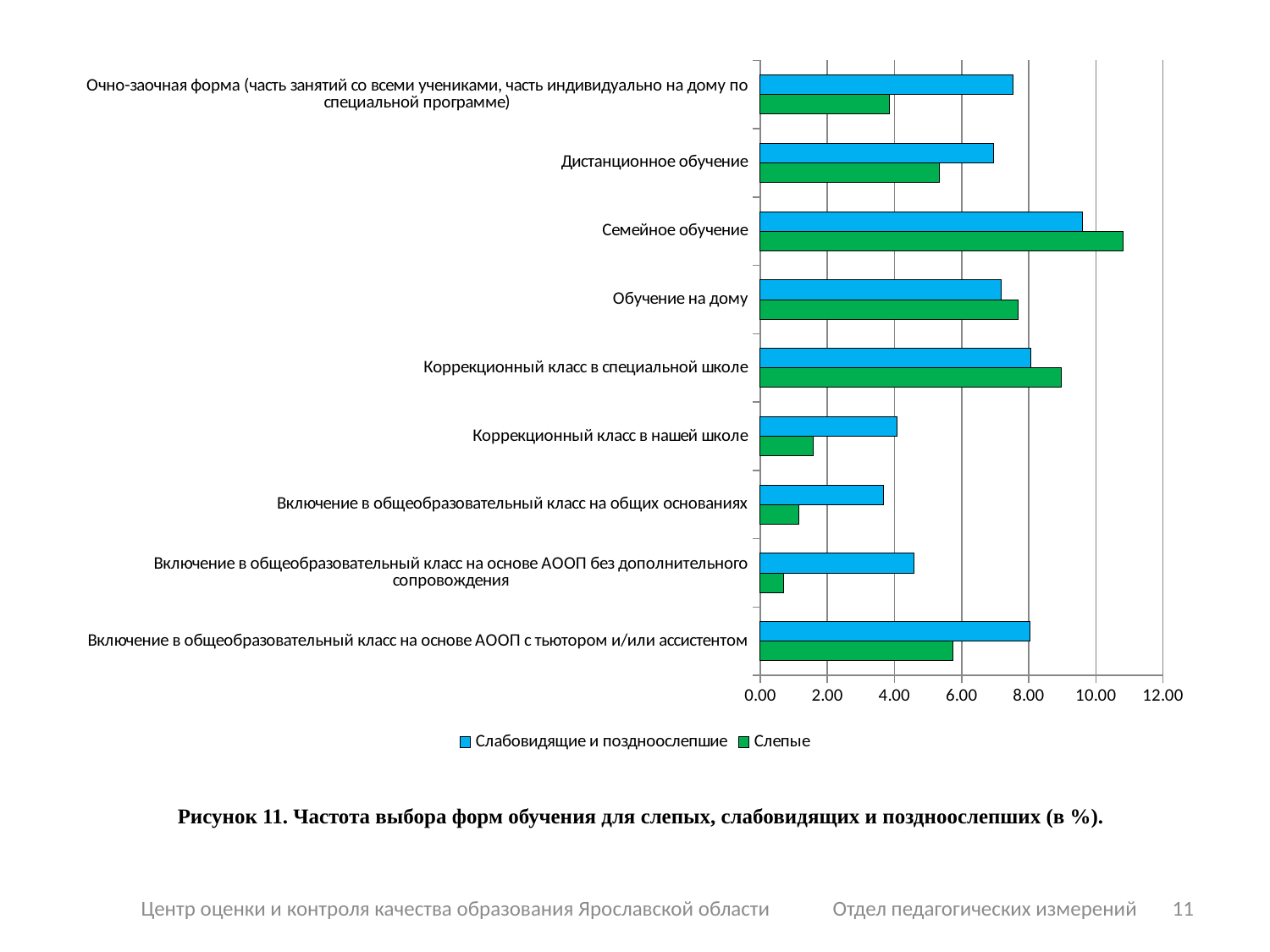
What kind of chart is shown on the slide? bar chart Is the value for "Семейное обучение" in the series "Слепые" greater or less than 10.00? greater How many categories (forms of education) are shown on the chart? 9 How many series does the legend list? 2 Which category has the lowest value for the series "Слепые"? Включение в общеобразовательный класс на основе АООП без дополнительного сопровождения For "Коррекционный класс в нашей школе", which series has the larger value: "Слепые" or "Слабовидящие и позднослепшие"? Слабовидящие и позднослепшие For "Семейное обучение", which series has the larger value: "Слепые" or "Слабовидящие и позднослепшие"? Слепые Is the value for "Коррекционный класс в специальной школе" in the series "Слепые" greater or less than 8.00? greater Which category has the highest value for the series "Слепые"? Семейное обучение Which colour represents the series "Слепые" in the legend? green Which category has the highest value for the series "Слабовидящие и позднослепшие"? Семейное обучение Is the value for "Включение в общеобразовательный класс на основе АООП без дополнительного сопровождения" in the series "Слепые" greater or less than 2.00? less